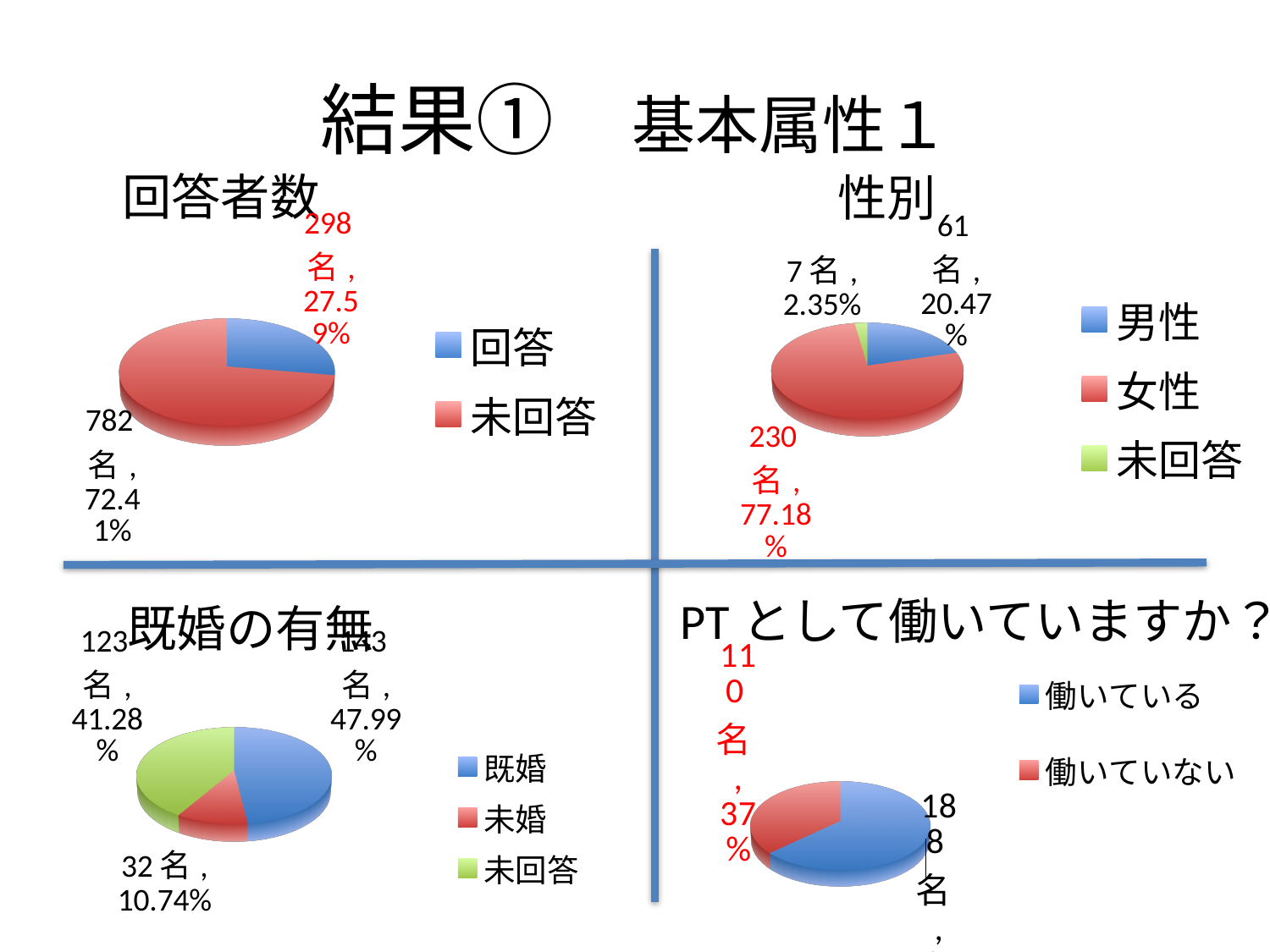
In the 回答者数 chart, what percentage share does 未回答 have? 72.41% How many categories does the legend of the 性別 chart list? 3 In the 回答者数 chart, how many respondents are in the 回答 category? 298名 In the 回答者数 chart, which category is larger, 回答 or 未回答? 未回答 In the 既婚の有無 chart, how many respondents are 未婚? 32名 In the PTとして働いていますか？ chart, how many respondents are 働いていない? 110名 In the 性別 chart, how many respondents are 女性? 230名 In the 性別 chart, what is the difference in count between 女性 and 男性? 169名 In the 性別 chart, what percentage share does 男性 have? 20.47% What type of chart is used for 回答者数? Pie chart In the 性別 chart, which category is the smallest? 未回答 In the 既婚の有無 chart, what percentage share does 未回答 have? 41.28%